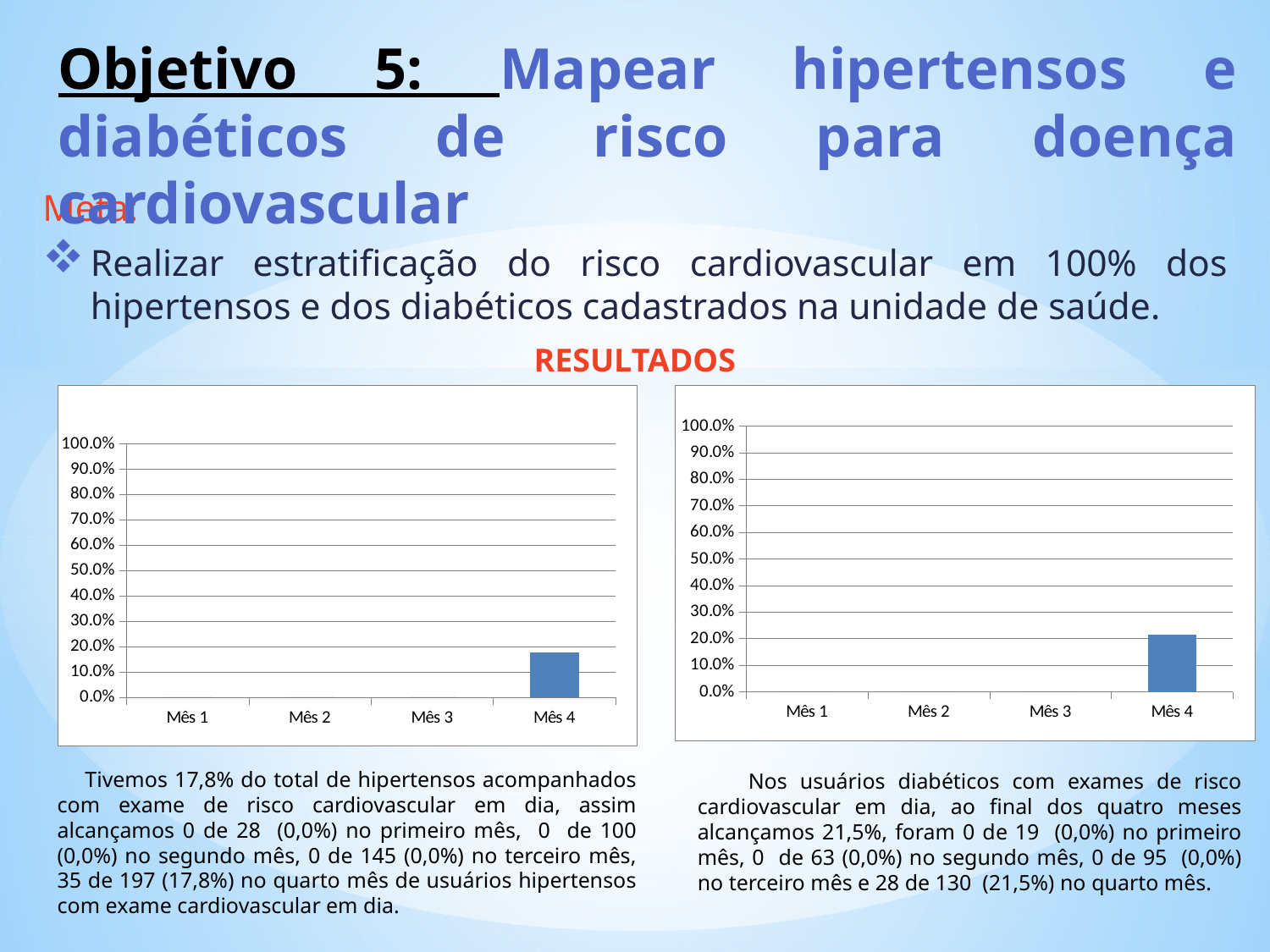
In the right chart, which month has the highest value? Mês 4 In the right chart, which is larger, the value for Mês 3 or the value for Mês 4? Mês 4 In the left chart, is the value for Mês 4 greater or less than 10.0%? greater How many categories are shown on the x axis of the left chart? 4 What kind of chart is the left chart on the slide? bar chart In the left chart, is the value for Mês 4 greater or less than 20.0%? less How many categories are shown on the x axis of the right chart? 4 What kind of chart is the right chart on the slide? bar chart In the left chart, what is the value for Mês 1? 0.0% In the right chart, what is the value for Mês 2? 0.0% In the left chart, which month has the highest value? Mês 4 In the right chart, is the value for Mês 4 greater or less than 30.0%? less